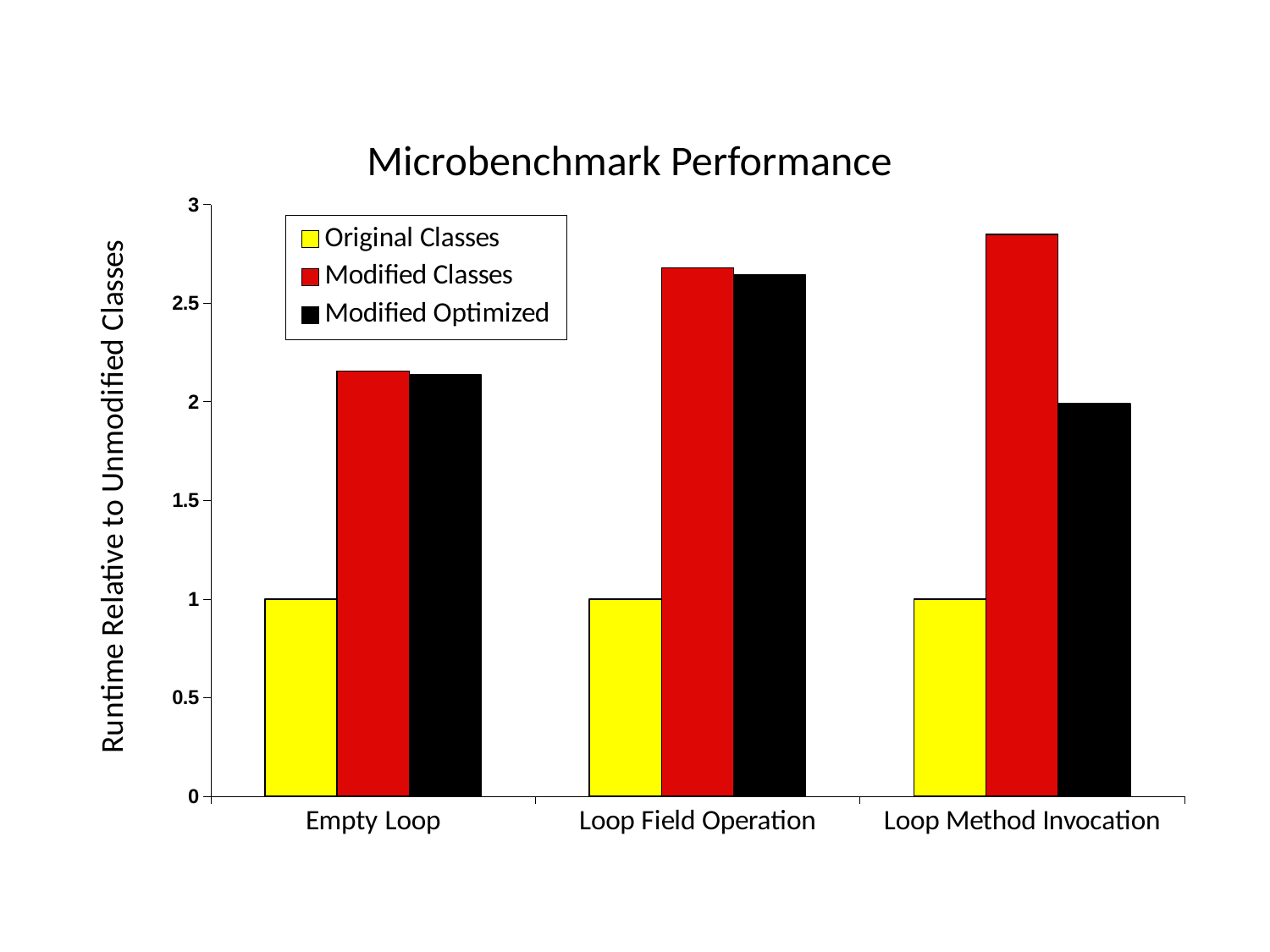
Which category has the lowest value for Modified Classes? Empty Loop How many categories are shown on the x axis? 3 In the Loop Method Invocation category, which is larger: Modified Classes or Modified Optimized? Modified Classes What is the value for Original Classes in the Loop Method Invocation category? 1 What is the value for Original Classes in the Empty Loop category? 1 Which category has the lowest value for Modified Optimized? Loop Method Invocation How many series does the legend list? 3 Is the value for Modified Classes in the Loop Field Operation category greater or less than 2.5? greater What is the label of the y axis? Runtime Relative to Unmodified Classes What kind of chart is shown on the slide? bar chart What is the title of the chart? Microbenchmark Performance Which category has the highest value for Modified Classes? Loop Method Invocation